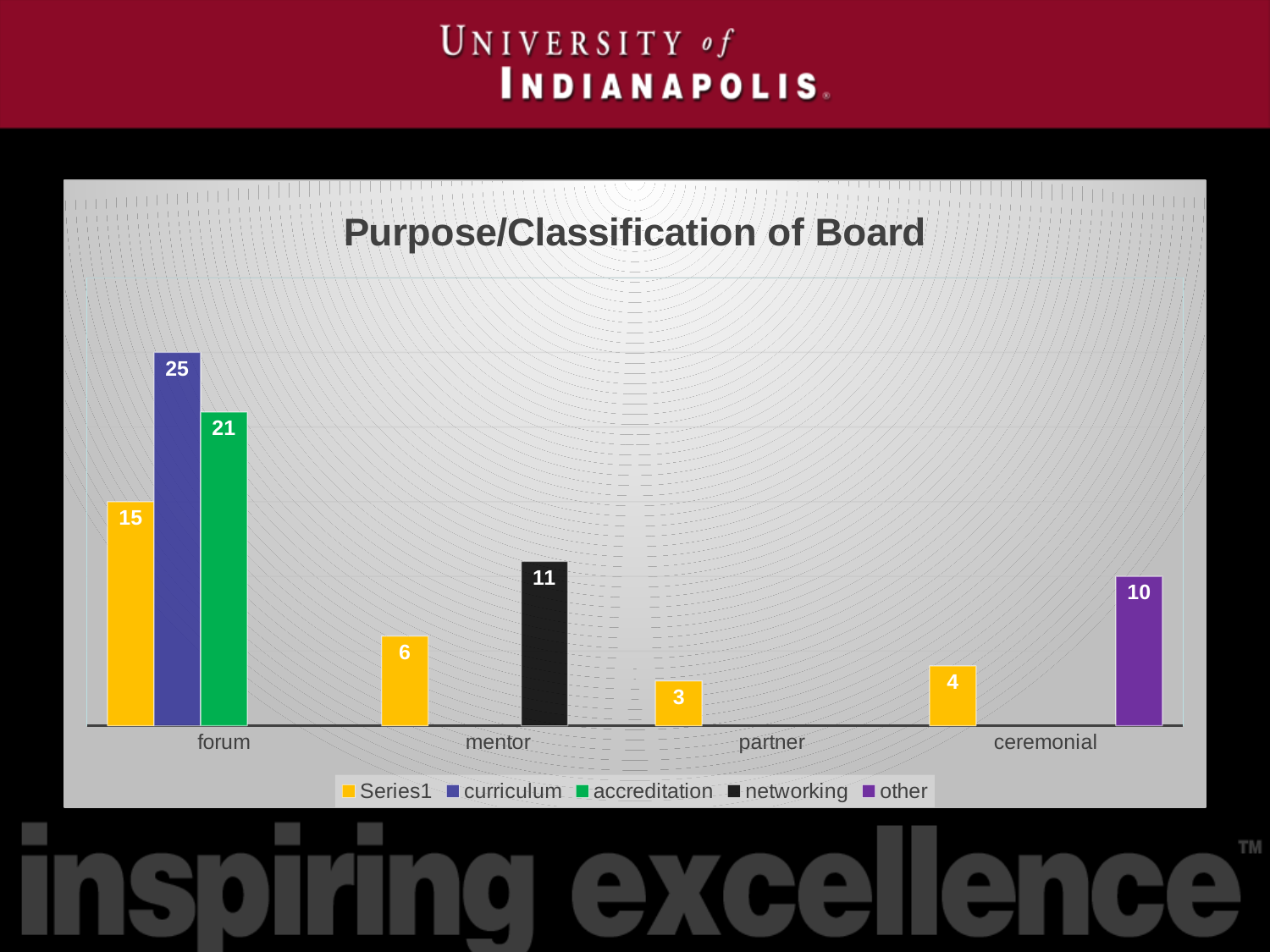
What is the value of the other bar in the ceremonial category? 10 What is the difference between the curriculum bar and the accreditation bar in the forum category? 4 What is the value of the Series1 bar for mentor? 6 What is the value of the networking bar in the mentor category? 11 Which bar has the highest value on the chart? curriculum (forum), 25 What is the value of the Series1 bar for partner? 3 Which bar has the lowest value on the chart? Series1 for partner, 3 What type of chart is shown on the slide? Bar chart Which is larger: the Series1 bar for forum or the networking bar for mentor? Series1 for forum How many series does the legend list? 5 What is the value of the curriculum bar in the forum category? 25 What is the value of the accreditation bar in the forum category? 21